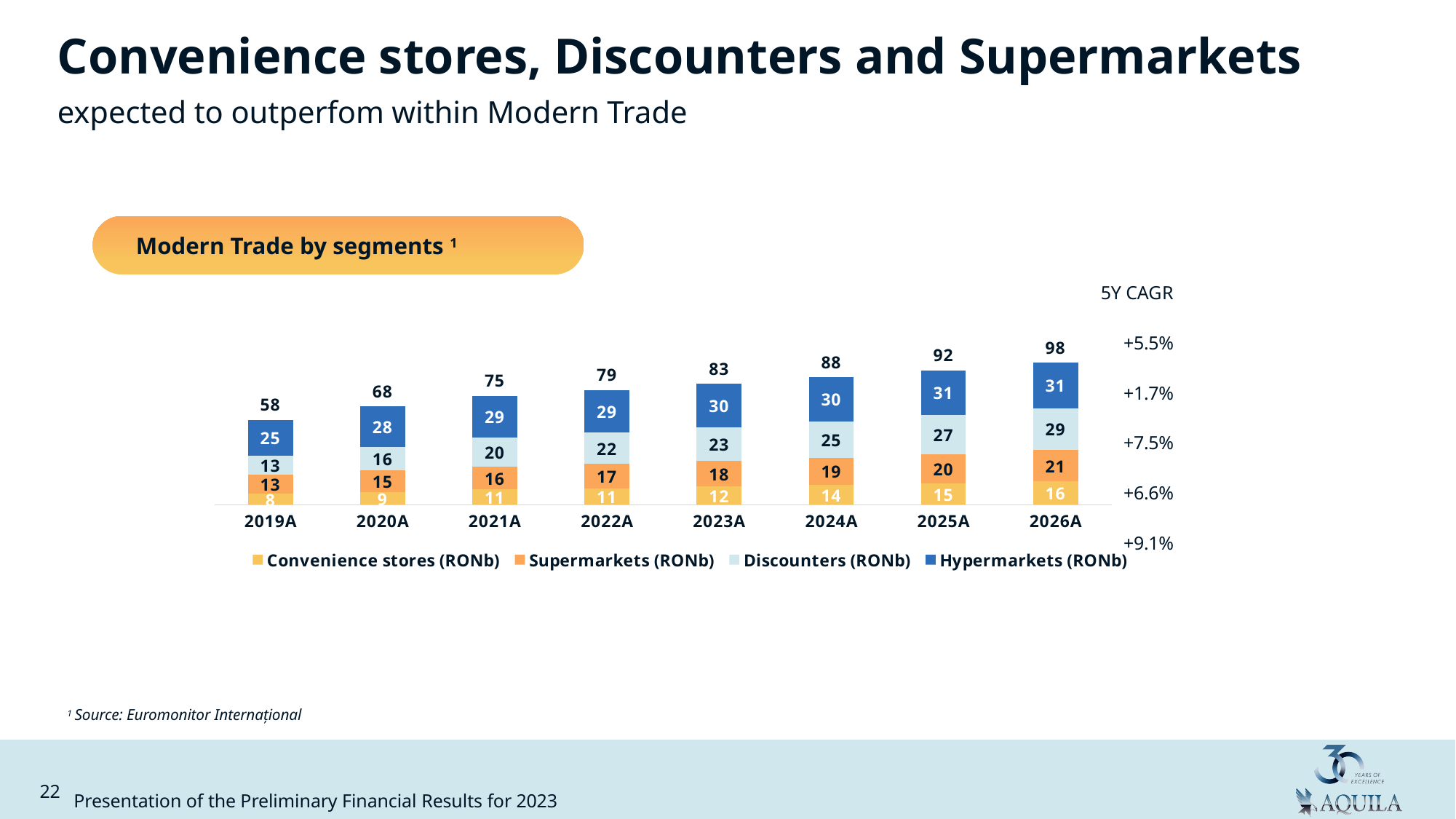
Which year has the lowest total Modern Trade value? 2019A Which year has the highest total Modern Trade value? 2026A How many years are shown on the x axis? 8 What is the difference between the total for 2026A and the total for 2019A? 40 What is the value for Convenience stores (RONb) in 2019A? 8 What is the total of the stacked bar for 2024A? 88 How many series does the legend list? 4 What is the value for Discounters (RONb) in 2022A? 22 What is the value for Hypermarkets (RONb) in 2023A? 30 Which is larger in 2021A: Discounters (RONb) or Supermarkets (RONb)? Discounters (RONb) What is the value for Supermarkets (RONb) in 2026A? 21 Do the total values rise or fall from 2019A to 2026A? rise